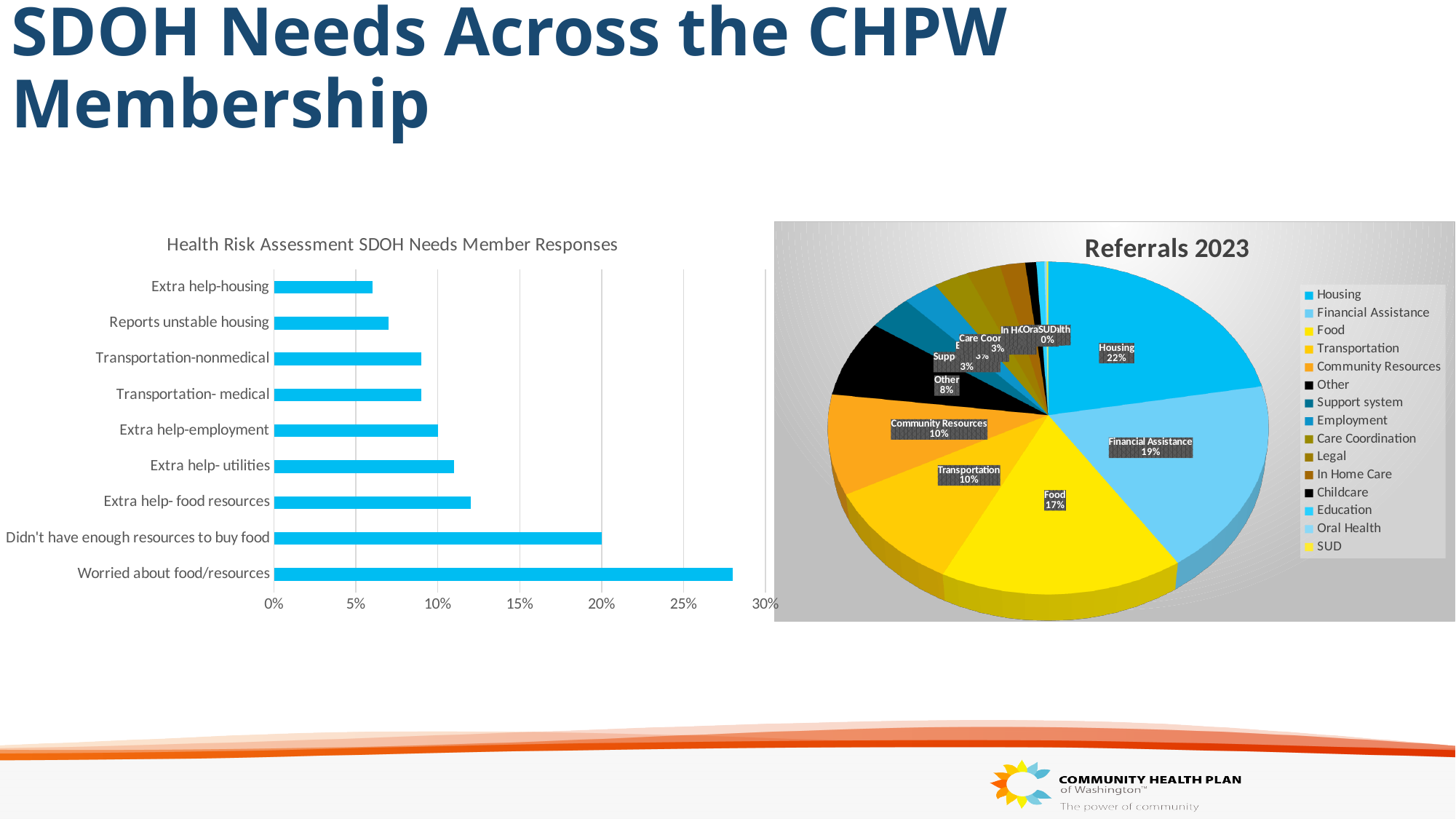
In the 'Health Risk Assessment SDOH Needs Member Responses' chart, which category has the highest value? Worried about food/resources In the 'Health Risk Assessment SDOH Needs Member Responses' chart, which category has the lowest value? Extra help-housing In the 'Referrals 2023' pie chart, what is the difference between the Housing share and the Food share? 5% What kind of chart is the 'Health Risk Assessment SDOH Needs Member Responses' chart on the left? bar chart In the 'Health Risk Assessment SDOH Needs Member Responses' chart, which is larger: 'Extra help- food resources' or 'Extra help-housing'? Extra help- food resources In the 'Health Risk Assessment SDOH Needs Member Responses' chart, is the value for 'Worried about food/resources' greater or less than 25%? greater In the 'Health Risk Assessment SDOH Needs Member Responses' chart, is the value for 'Reports unstable housing' greater or less than 10%? less In the 'Health Risk Assessment SDOH Needs Member Responses' chart, how many categories are plotted? 9 In the 'Referrals 2023' pie chart, what share is labelled for Financial Assistance? 19% What kind of chart is the 'Referrals 2023' chart on the right? pie chart In the 'Referrals 2023' pie chart, what share is labelled for Housing? 22% How many entries does the legend of the 'Referrals 2023' pie chart list? 15